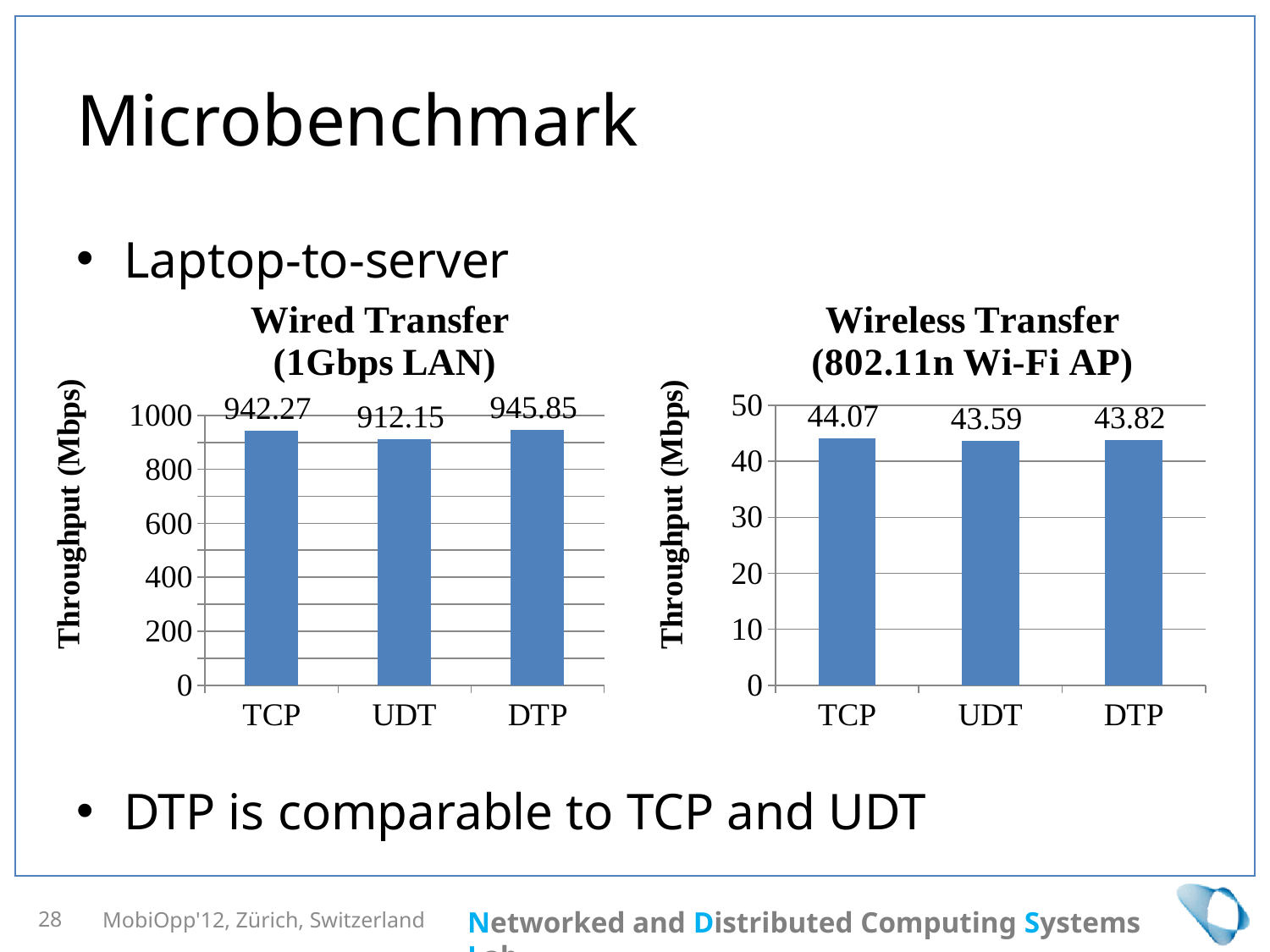
What is the y-axis label of the Wired Transfer (1Gbps LAN) chart? Throughput (Mbps) What kind of chart is the Wireless Transfer (802.11n Wi-Fi AP) chart? Bar chart In the Wired Transfer (1Gbps LAN) chart, which protocol has the lowest throughput? UDT In the Wired Transfer (1Gbps LAN) chart, what is the throughput for TCP? 942.27 In the Wired Transfer (1Gbps LAN) chart, how many protocols are plotted? 3 In the Wireless Transfer (802.11n Wi-Fi AP) chart, which protocol has the highest throughput? TCP In the Wireless Transfer (802.11n Wi-Fi AP) chart, what is the throughput for UDT? 43.59 In the Wireless Transfer (802.11n Wi-Fi AP) chart, what is the throughput for DTP? 43.82 In the Wired Transfer (1Gbps LAN) chart, which protocol has the highest throughput? DTP In the Wired Transfer (1Gbps LAN) chart, what is the throughput for UDT? 912.15 In the Wired Transfer (1Gbps LAN) chart, what is the difference between the DTP and UDT throughputs? 33.7 In the Wireless Transfer (802.11n Wi-Fi AP) chart, what is the difference between the TCP and UDT throughputs? 0.48